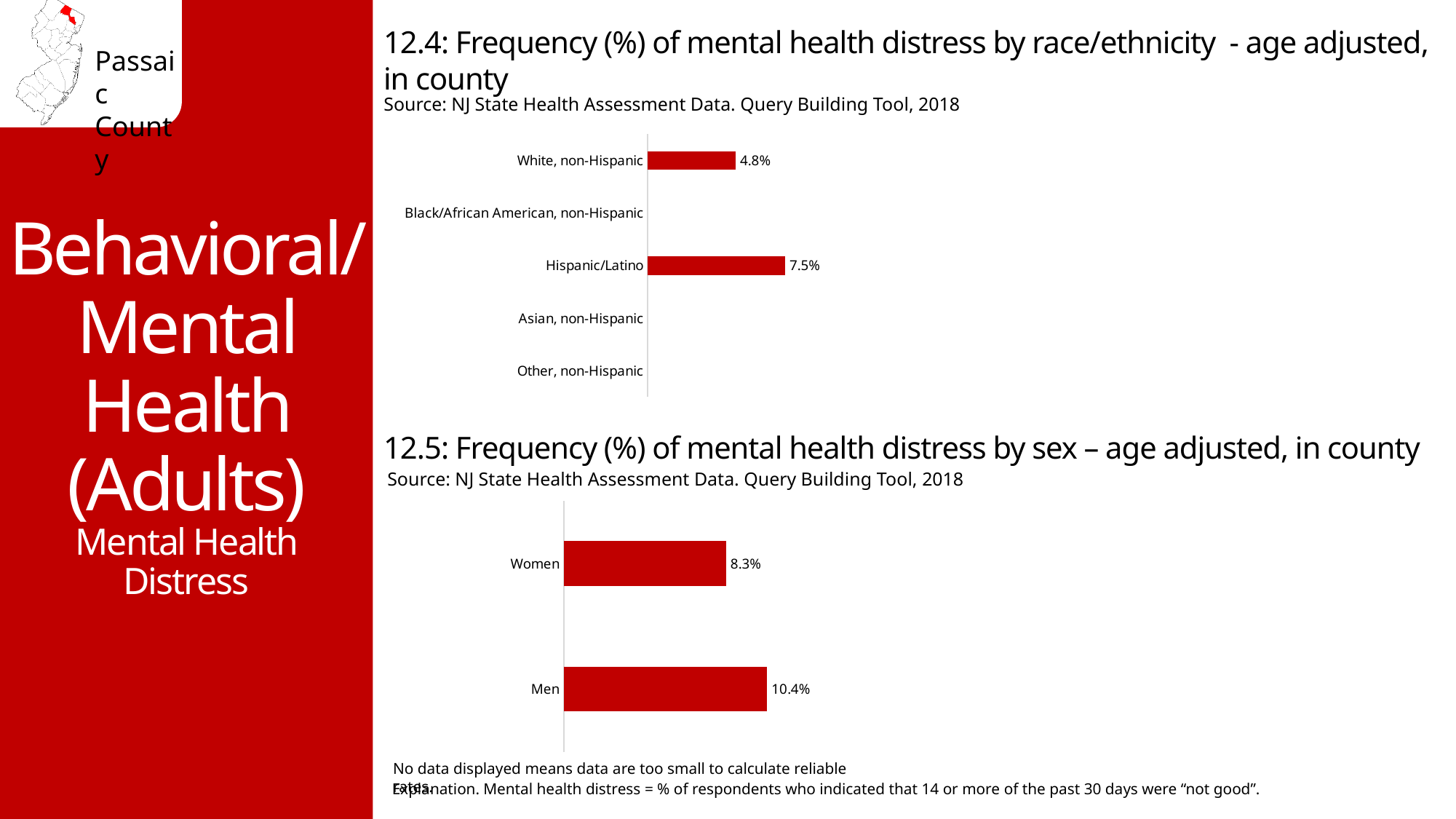
In chart 12.4 (mental health distress by race/ethnicity), what is the difference between the Hispanic/Latino and White, non-Hispanic values? 2.7% What kind of chart is chart 12.4 (mental health distress by race/ethnicity)? Bar chart In chart 12.5 (mental health distress by sex), which group has the higher value, Women or Men? Men In chart 12.5 (mental health distress by sex), what is the value for Women? 8.3% What is the source cited for chart 12.5 (mental health distress by sex)? NJ State Health Assessment Data. Query Building Tool, 2018 In chart 12.5 (mental health distress by sex), what is the difference between the Men and Women values? 2.1% In chart 12.5 (mental health distress by sex), what is the value for Men? 10.4% In chart 12.4 (mental health distress by race/ethnicity), how many race/ethnicity categories are listed on the axis? 5 In chart 12.4 (mental health distress by race/ethnicity), what is the value for White, non-Hispanic? 4.8% In chart 12.4 (mental health distress by race/ethnicity), what is the value for Hispanic/Latino? 7.5% In chart 12.4 (mental health distress by race/ethnicity), which category has the highest value shown? Hispanic/Latino In chart 12.4 (mental health distress by race/ethnicity), how many categories have a bar displayed? 2